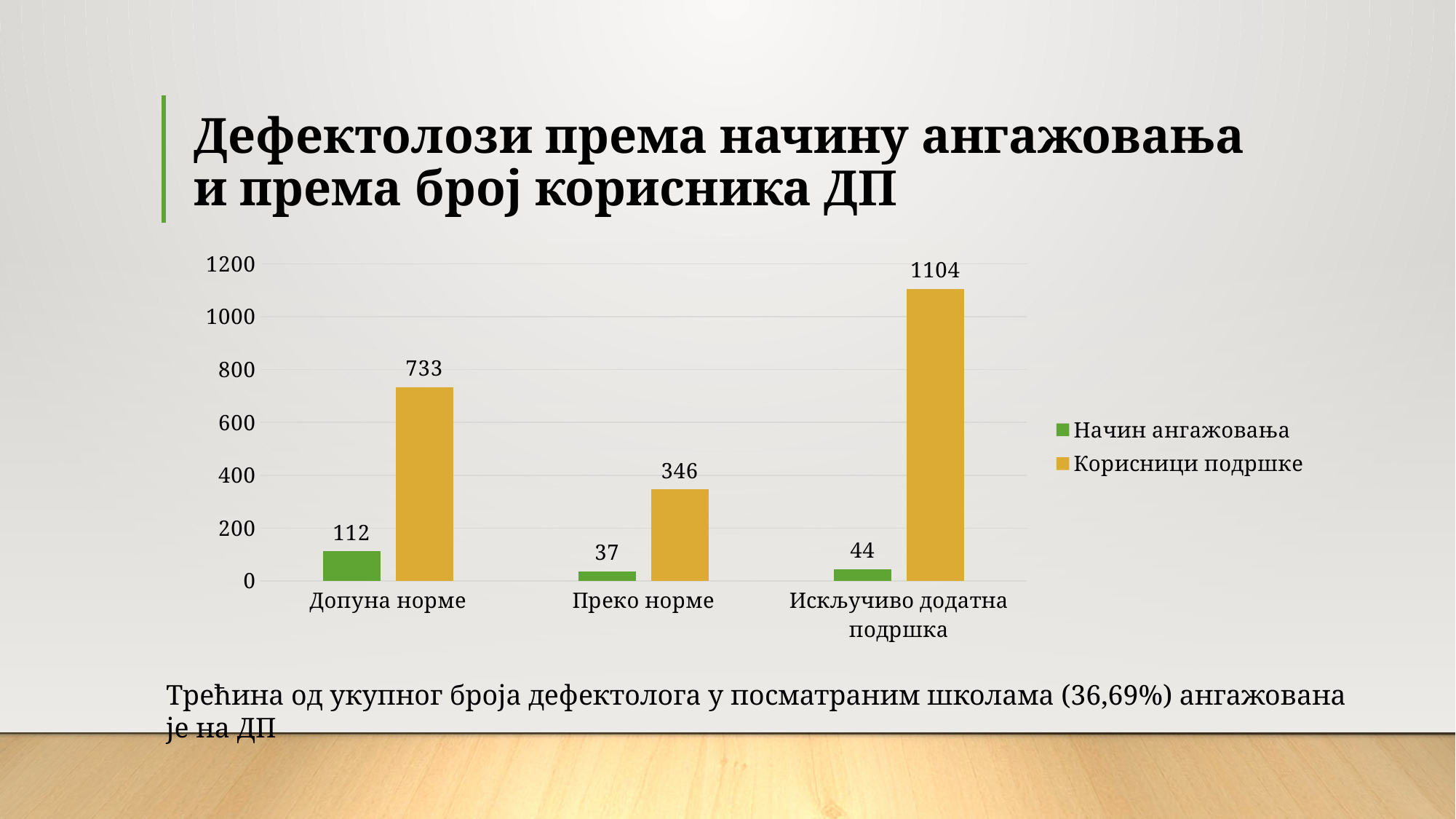
Which category has the highest value for Корисници подршке? Искључиво додатна подршка How many series does the legend list? 2 Which category has the lowest value for Начин ангажовања? Преко норме What is the value of Корисници подршке for Допуна норме? 733 How many categories are shown on the x axis? 3 Which is larger: Начин ангажовања for Допуна норме or for Искључиво додатна подршка? Допуна норме What is the difference between Корисници подршке for Искључиво додатна подршка and for Допуна норме? 371 What is the value of Начин ангажовања for Преко норме? 37 What is the value of Корисници подршке for Искључиво додатна подршка? 1104 Which colour represents the series Корисници подршке? yellow Is the value of Корисници подршке for Преко норме greater or less than 400? less What kind of chart is shown on the slide? bar chart